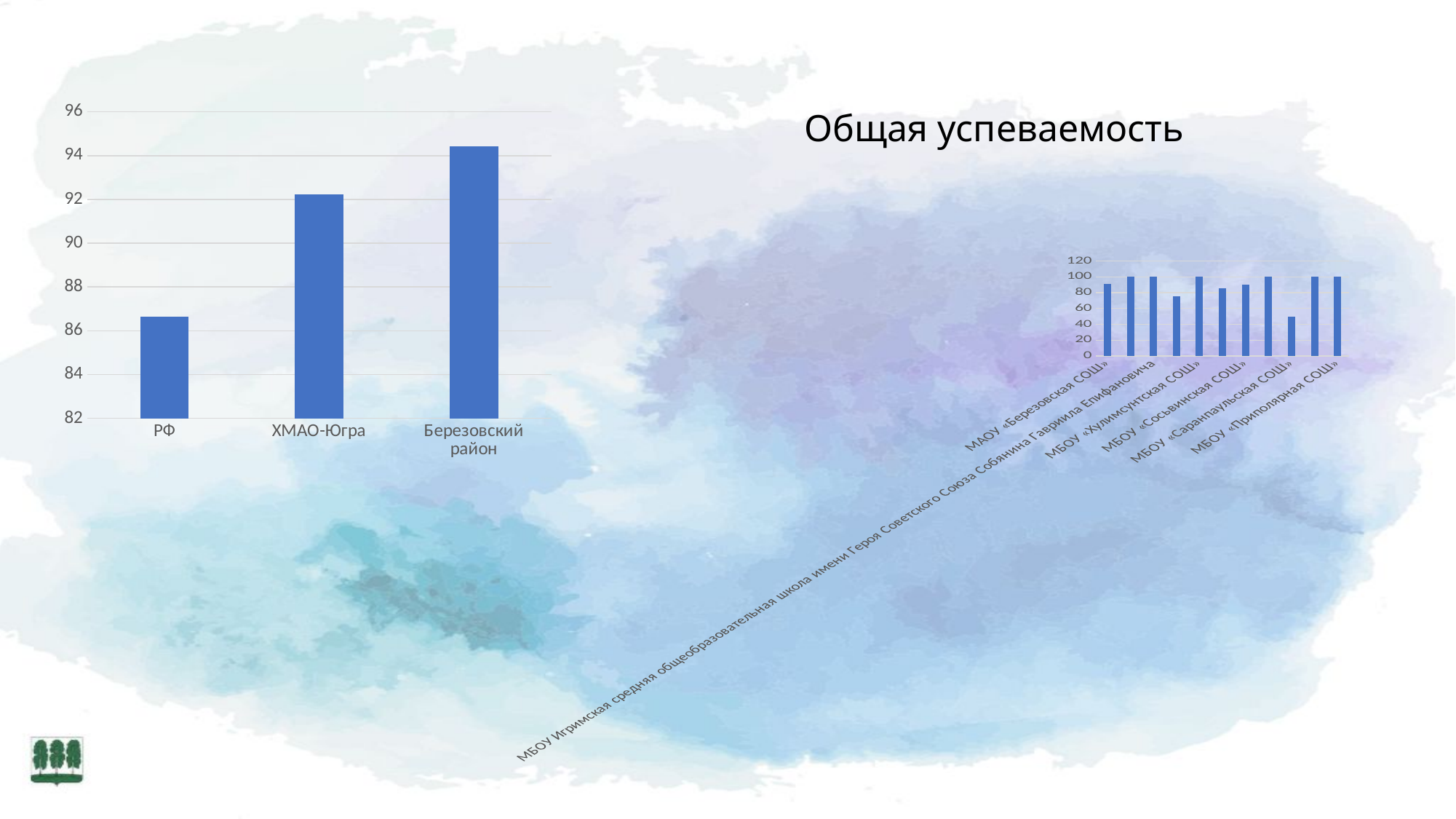
How many bars does the chart on the right of the slide show? 11 What is the title shown above the chart on the right of the slide? Общая успеваемость In the chart on the left of the slide, which category has the lowest value? РФ In the chart on the left of the slide, which is larger, the value for РФ or the value for ХМАО-Югра? ХМАО-Югра In the chart on the left of the slide, do the values rise or fall from РФ to Березовский район? rise In the chart on the left of the slide, which category has the highest value? Березовский район In the chart on the left of the slide, is the value for РФ greater or less than 88? less In the chart on the left of the slide, is the value for Березовский район greater or less than 92? greater What kind of chart is the chart on the right of the slide? bar chart What kind of chart is the chart on the left of the slide? bar chart In the chart on the left of the slide, is the value for ХМАО-Югра greater or less than 90? greater How many categories does the chart on the left of the slide show? 3